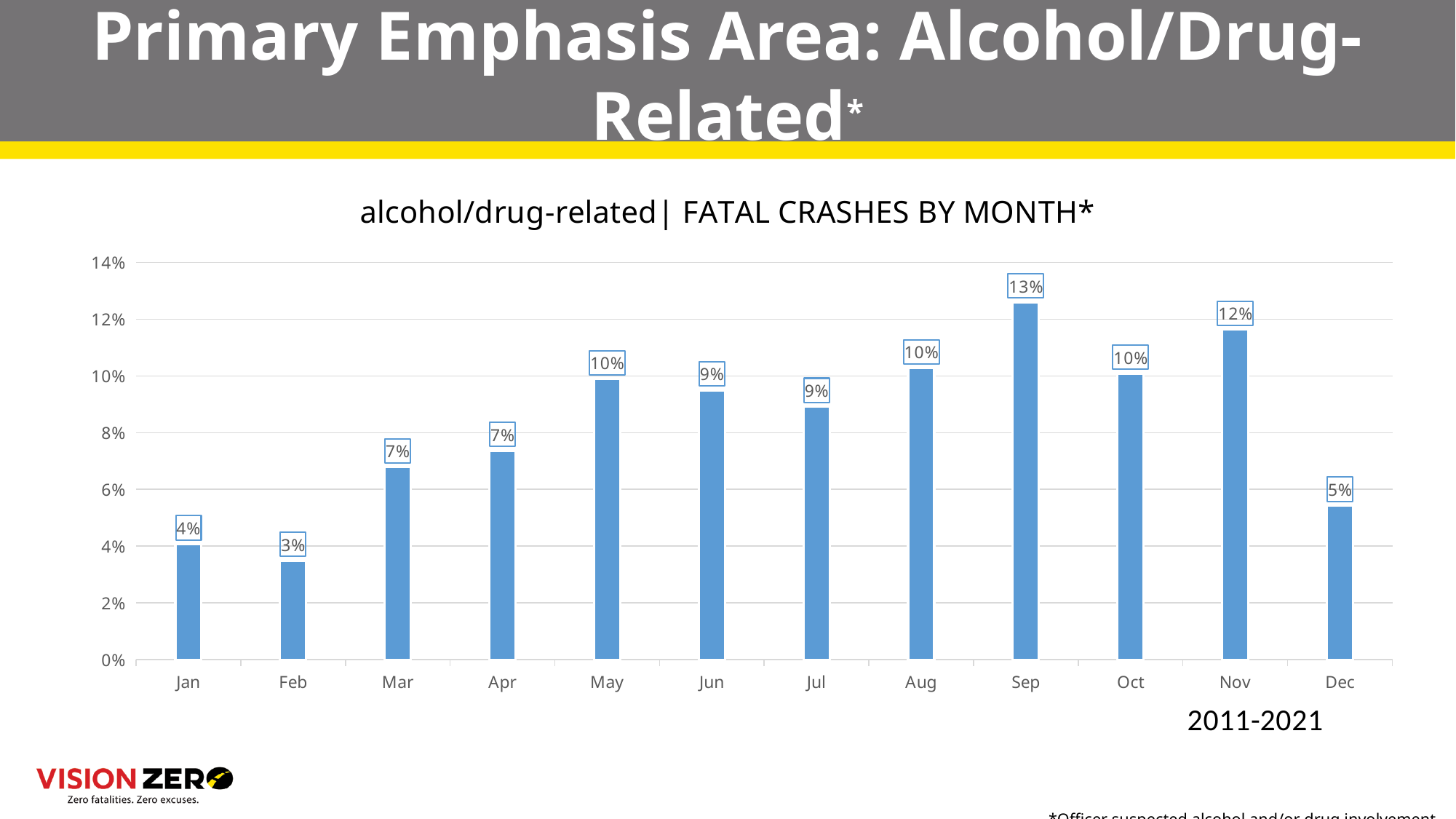
Which month has the highest share of alcohol/drug-related fatal crashes? Sep What percentage of alcohol/drug-related fatal crashes occurred in September? 13% What is the value shown for December? 5% Which month has the lowest share of alcohol/drug-related fatal crashes? Feb What is the value shown for February? 3% Is the value for September greater or less than 12%? greater Which month has a larger value, January or December? Dec What type of chart is shown on the slide? Bar chart What is the difference between the values for September and February? 10% What is the value shown for November? 12% What is the title of the chart? alcohol/drug-related| FATAL CRASHES BY MONTH* How many months are shown on the x axis of the chart? 12